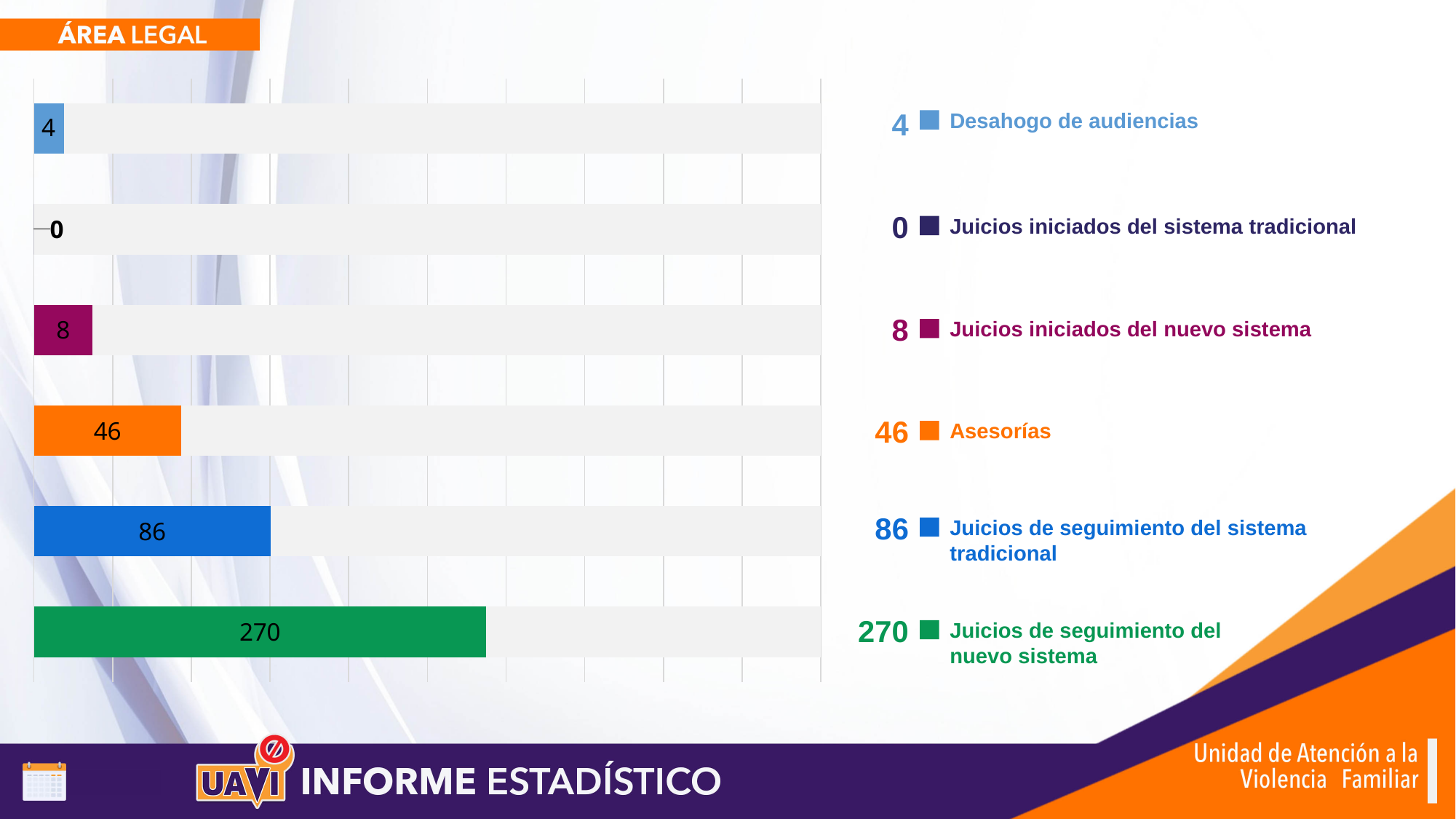
What is the value for Asesorías? 46 Which is larger, Juicios de seguimiento del sistema tradicional or Asesorías? Juicios de seguimiento del sistema tradicional What is the value for Juicios iniciados del sistema tradicional? 0 What is the value for Juicios de seguimiento del nuevo sistema? 270 Which category has the lowest value? Juicios iniciados del sistema tradicional What is the difference between Juicios de seguimiento del nuevo sistema and Juicios de seguimiento del sistema tradicional? 184 What is the value for Desahogo de audiencias? 4 What is the difference between Asesorías and Juicios iniciados del nuevo sistema? 38 Which category has the highest value? Juicios de seguimiento del nuevo sistema What kind of chart is shown on the slide? Bar chart What colour is the bar for Juicios de seguimiento del nuevo sistema? Green How many categories are shown in the chart? 6